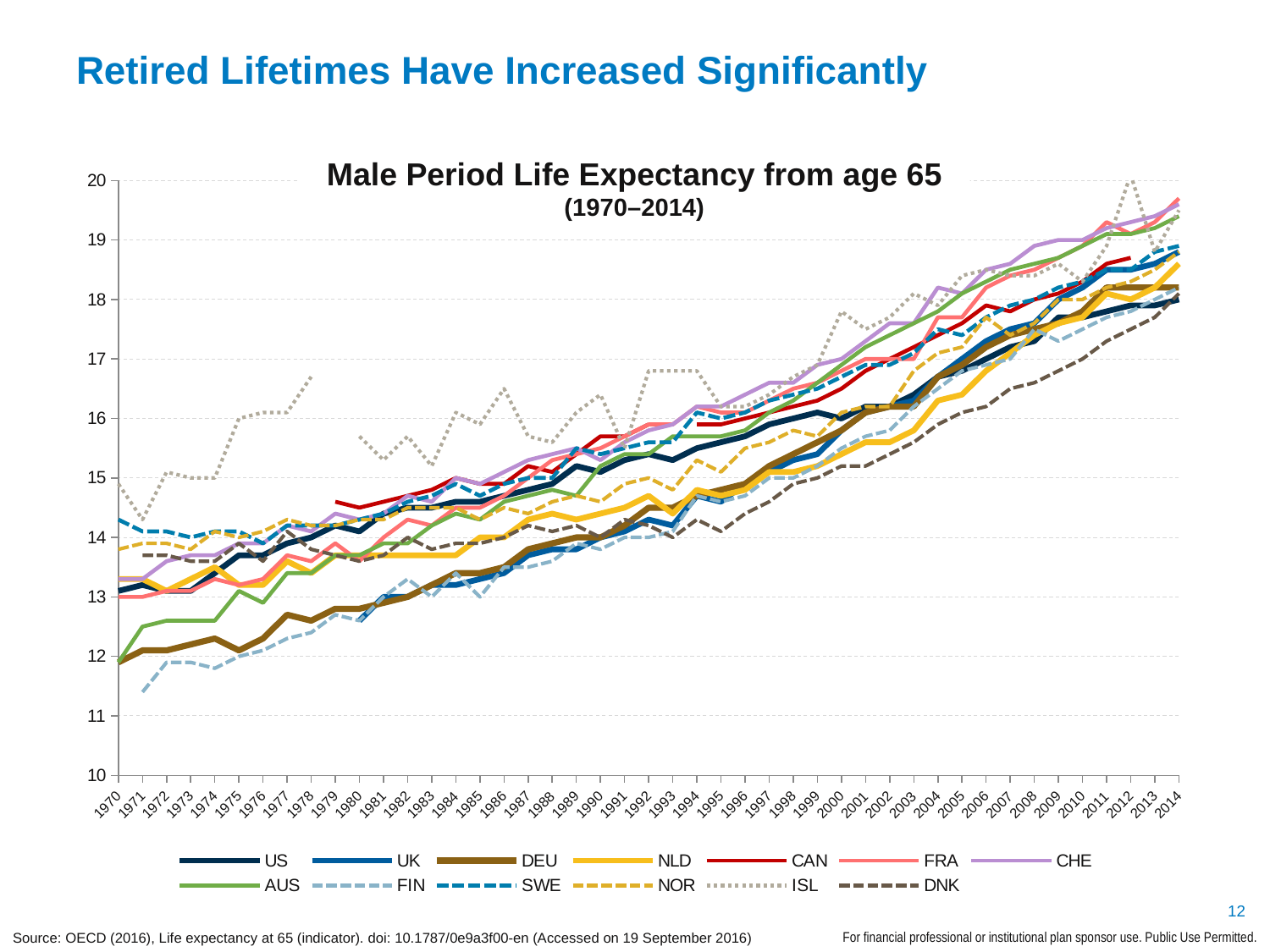
In 2014, which is higher, CHE or DNK? CHE What kind of chart is shown on the slide? line chart What is the title of the chart? Male Period Life Expectancy from age 65 (1970–2014) How many years are shown along the x axis? 45 Is the value for FIN in 1980 greater or less than 13? less Which series has the highest value in 1970? ISL Do the life expectancy values generally rise or fall from 1970 to 2014? rise Which series has the lowest value in 1971? FIN Is the value for CHE in 2014 greater or less than 19? greater Is the value for SWE in 1970 greater or less than 14? greater How many series does the legend list? 13